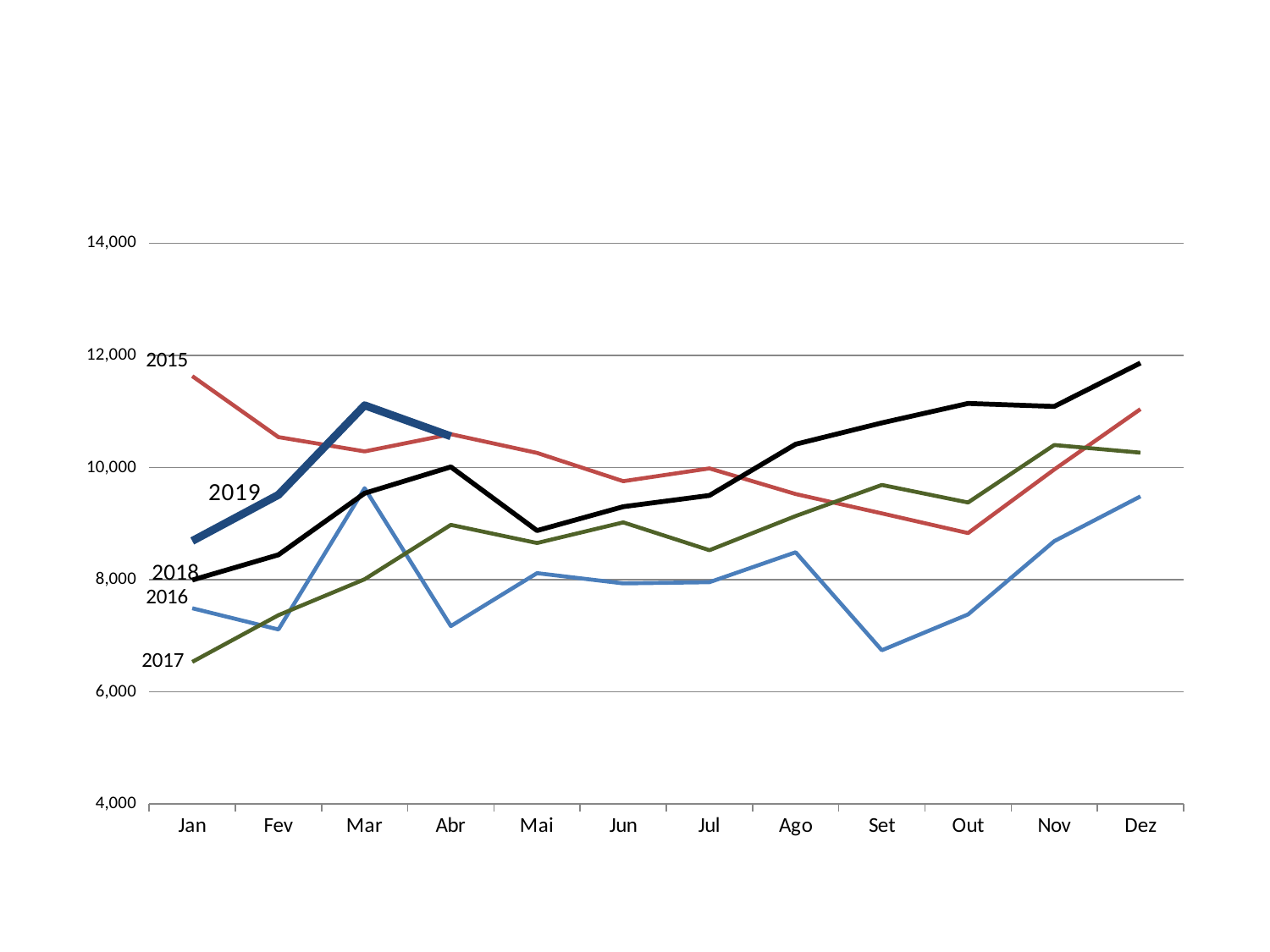
In which month does the 2016 series reach its lowest value? Set How many year series are plotted on the chart? 5 In which month does the 2018 series reach its highest value? Dez How many months are shown along the x axis? 12 Is the value for 2015 in Jan greater or less than 10,000? greater In Mar, which series has the higher value, 2016 or 2017? 2016 Is the value for 2016 in Set greater or less than 8,000? less In Dez, which series has the higher value, 2018 or 2015? 2018 Is the value for 2019 in Mar greater or less than 10,000? greater Does the 2018 series rise or fall from Ago to Dez? rise What kind of chart is shown on the slide? line chart